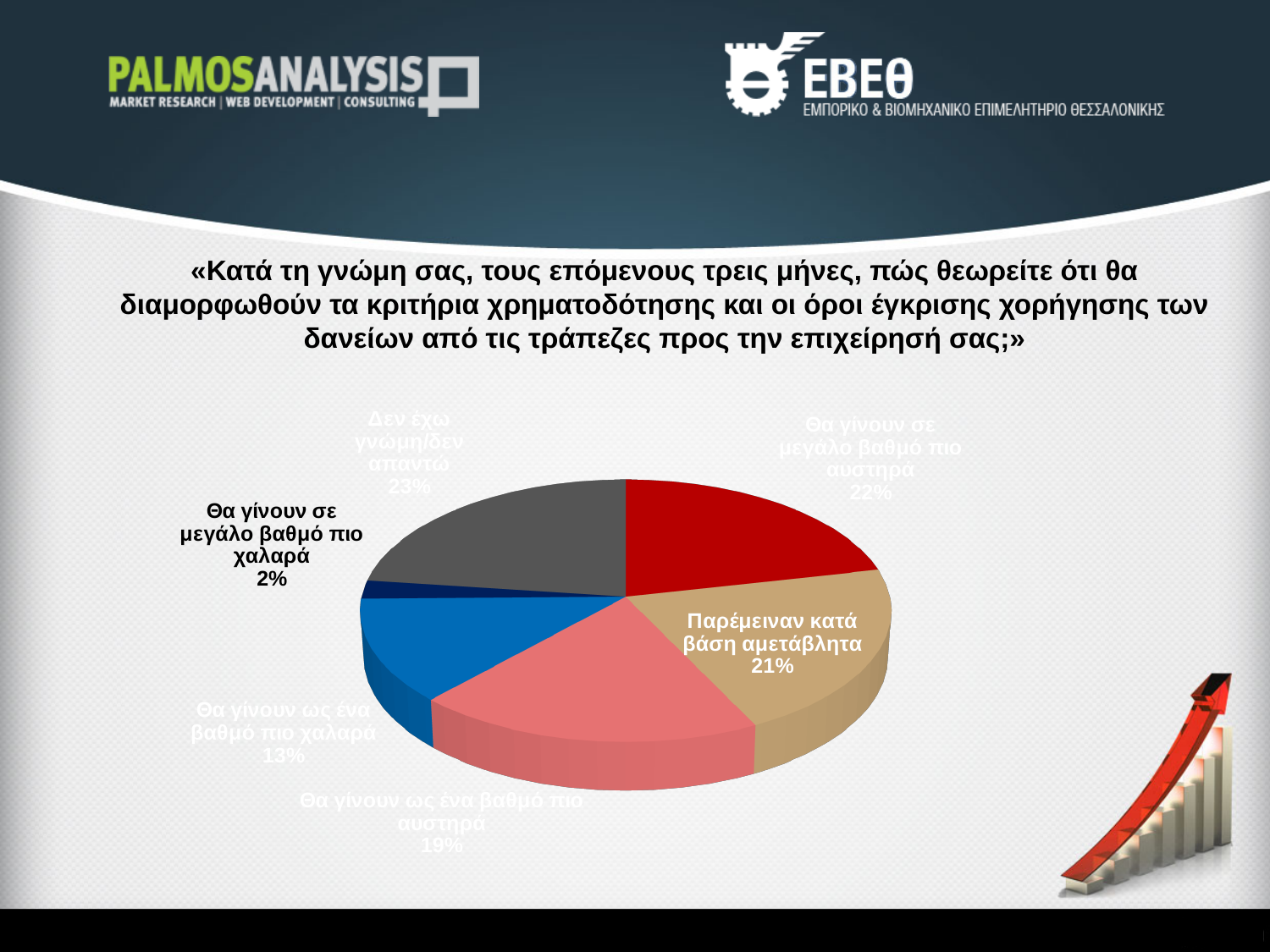
What percentage is shown for "Θα γίνουν ως ένα βαθμό πιο χαλαρά"? 13% What percentage is shown for "Θα γίνουν σε μεγάλο βαθμό πιο χαλαρά"? 2% What is the difference in percentage points between "Θα γίνουν ως ένα βαθμό πιο αυστηρά" and "Θα γίνουν ως ένα βαθμό πιο χαλαρά"? 6 Which slice has the largest share of the pie? Δεν έχω γνώμη/δεν απαντώ Which is larger: the share for "Παρέμειναν κατά βάση αμετάβλητα" or the share for "Θα γίνουν ως ένα βαθμό πιο χαλαρά"? Παρέμειναν κατά βάση αμετάβλητα What percentage is shown for "Θα γίνουν σε μεγάλο βαθμό πιο αυστηρά"? 22% What colour is the slice for "Παρέμειναν κατά βάση αμετάβλητα"? Tan/beige What percentage is shown for "Παρέμειναν κατά βάση αμετάβλητα"? 21% How many slices does the pie chart have? 6 What kind of chart is shown on the slide? Pie chart Which slice has the smallest share of the pie? Θα γίνουν σε μεγάλο βαθμό πιο χαλαρά What percentage is shown for "Θα γίνουν ως ένα βαθμό πιο αυστηρά"? 19%